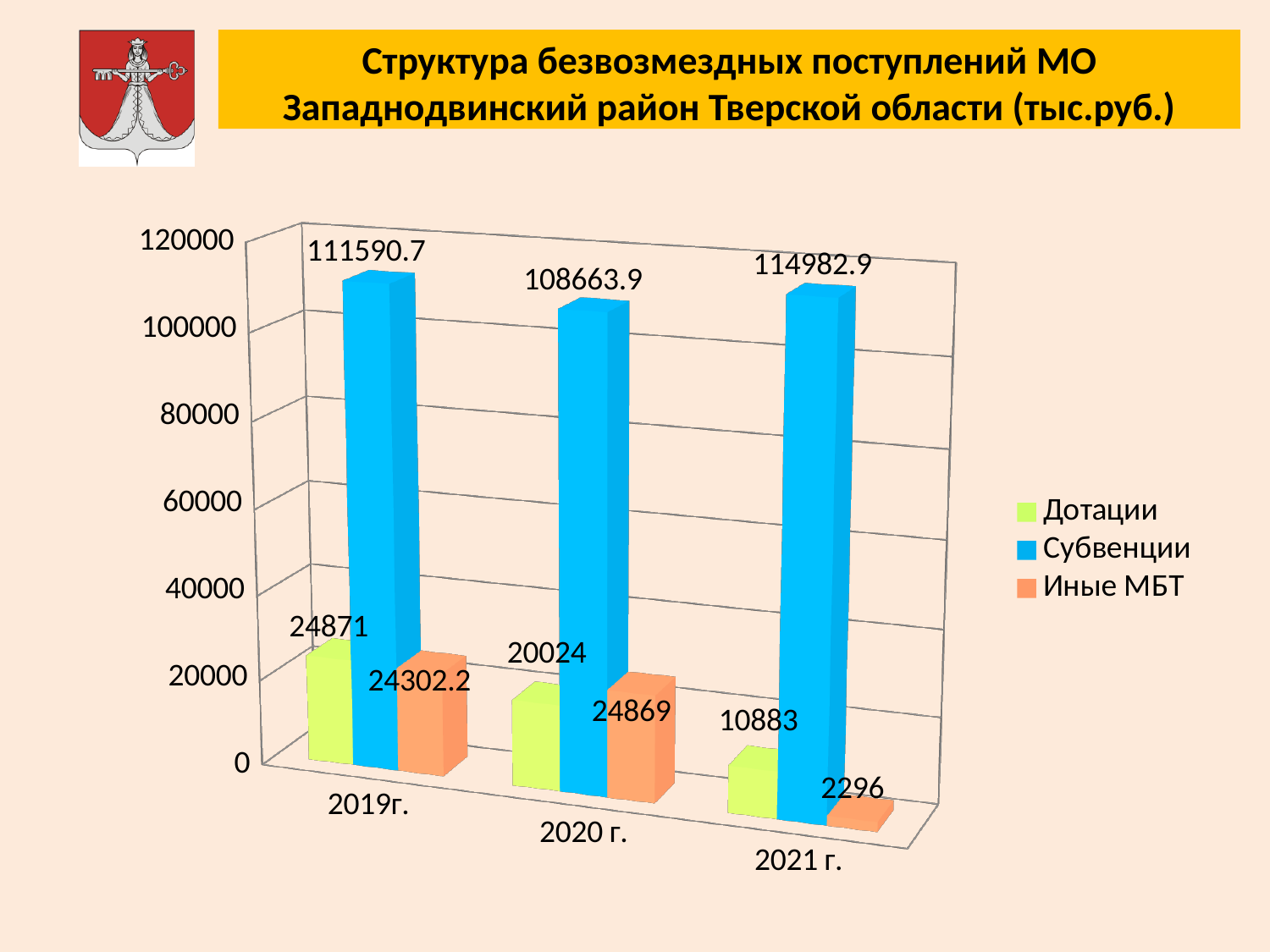
In which year is the value of Дотации the lowest? 2021 г. What is the difference between the Субвенции values for 2021 г. and 2020 г.? 6319 What is the value of Иные МБТ for 2021 г.? 2296 How many series does the legend list? 3 What is the value of Дотации for 2020 г.? 20024 How many years are shown on the x axis? 3 Do the Дотации values rise or fall from 2019г. to 2021 г.? fall In which year is the value of Субвенции the highest? 2021 г. Is the value of Субвенции for 2020 г. greater or less than 100000? greater Which is larger in 2020 г.: Дотации or Иные МБТ? Иные МБТ What is the difference between the Дотации values for 2019г. and 2021 г.? 13988 What is the value of Субвенции for 2019г.? 111590.7